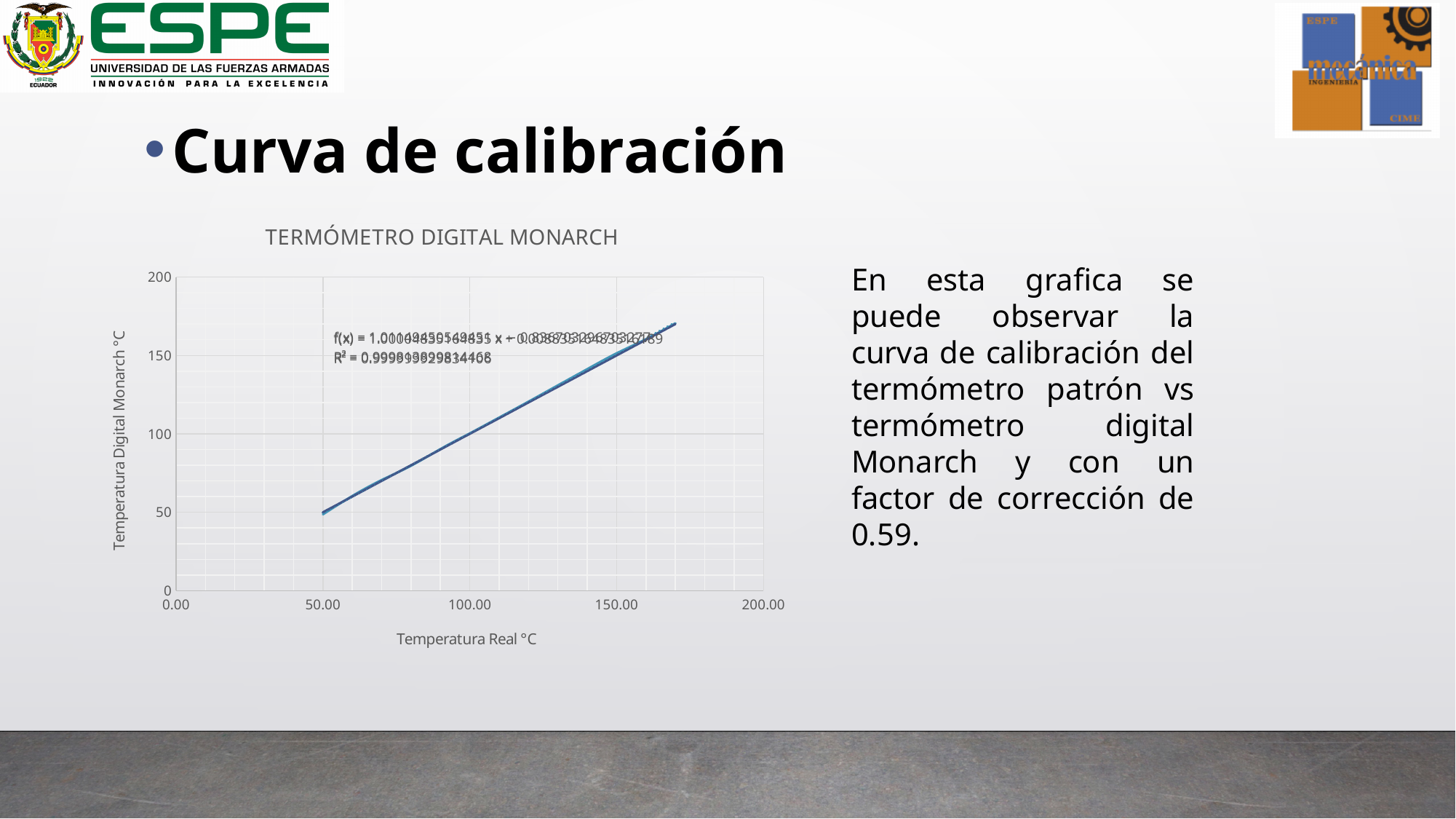
Is the lowest plotted Temperatura Digital Monarch value greater or less than 100? less What is the label of the x axis of the chart? Temperatura Real °C What is the title of the chart? TERMÓMETRO DIGITAL MONARCH Is the Temperatura Digital Monarch value at a Temperatura Real of 50.00 greater or less than 100? less Is the highest plotted Temperatura Digital Monarch value greater or less than 150? greater Do the plotted values rise or fall as Temperatura Real increases along the x axis? rise What is the maximum value shown on the y axis of the chart? 200